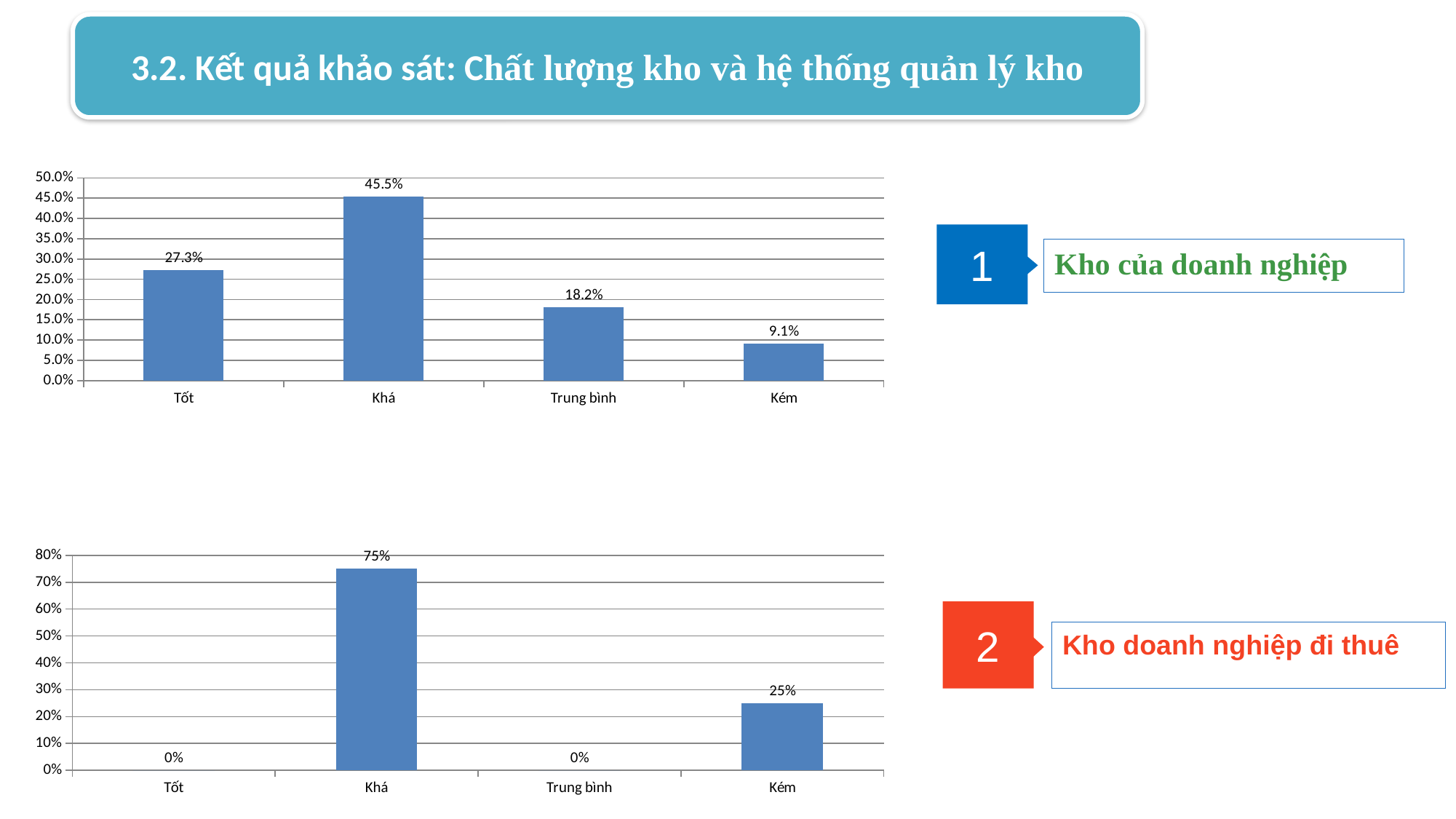
In the top chart (Kho của doanh nghiệp), how many categories are shown on the x axis? 4 In the top chart (Kho của doanh nghiệp), which category has the lowest value? Kém In the top chart (Kho của doanh nghiệp), what is the value for Khá? 45.5% In the top chart (Kho của doanh nghiệp), what is the value for Kém? 9.1% What type of chart is the top chart (Kho của doanh nghiệp)? bar chart In the bottom chart (Kho doanh nghiệp đi thuê), what is the value for Trung bình? 0% In the bottom chart (Kho doanh nghiệp đi thuê), what is the value for Khá? 75% In the bottom chart (Kho doanh nghiệp đi thuê), is the value for Kém larger or smaller than the value for Khá? smaller In the bottom chart (Kho doanh nghiệp đi thuê), what is the difference between the values for Khá and Kém? 50% In the top chart (Kho của doanh nghiệp), which category has the highest value? Khá In the bottom chart (Kho doanh nghiệp đi thuê), which category has the highest value? Khá In the top chart (Kho của doanh nghiệp), what is the difference between the values for Tốt and Trung bình? 9.1%